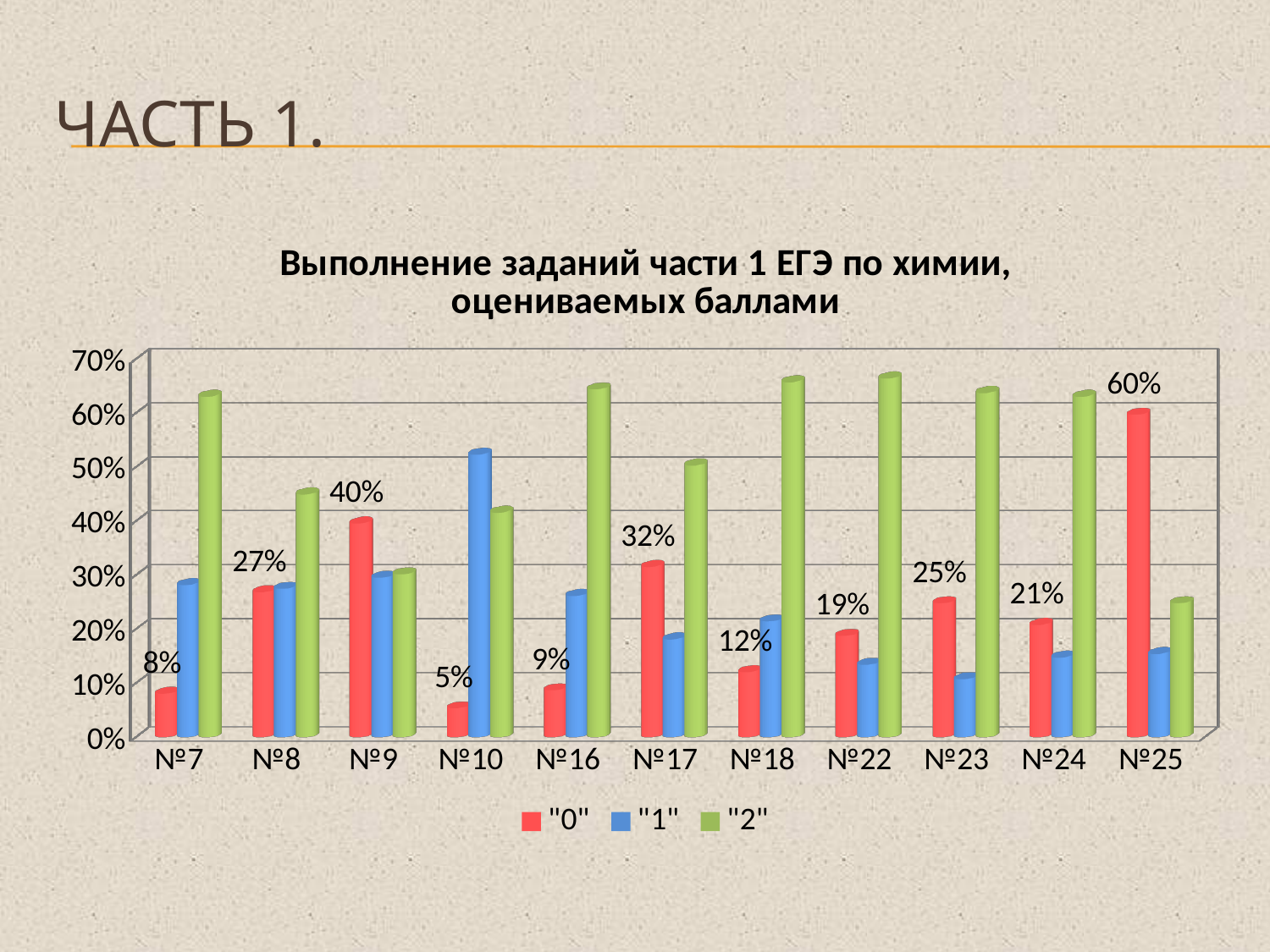
What is the value of the "0" series for №25? 60% How many tasks (categories) are shown on the x axis? 11 Is the value of the "1" series for №10 greater or less than 40%? greater What kind of chart is shown on the slide? Bar chart What is the value of the "0" series for №17? 32% How many series does the legend list? 3 What is the difference between the "0" series values for №25 and №9? 20% What is the value of the "0" series for №10? 5% Is the value of the "2" series for №25 greater or less than 30%? less In the "0" series, which is larger: №23 or №24? №23 Which task has the lowest value in the "0" series? №10 Which task has the highest value in the "0" series? №25